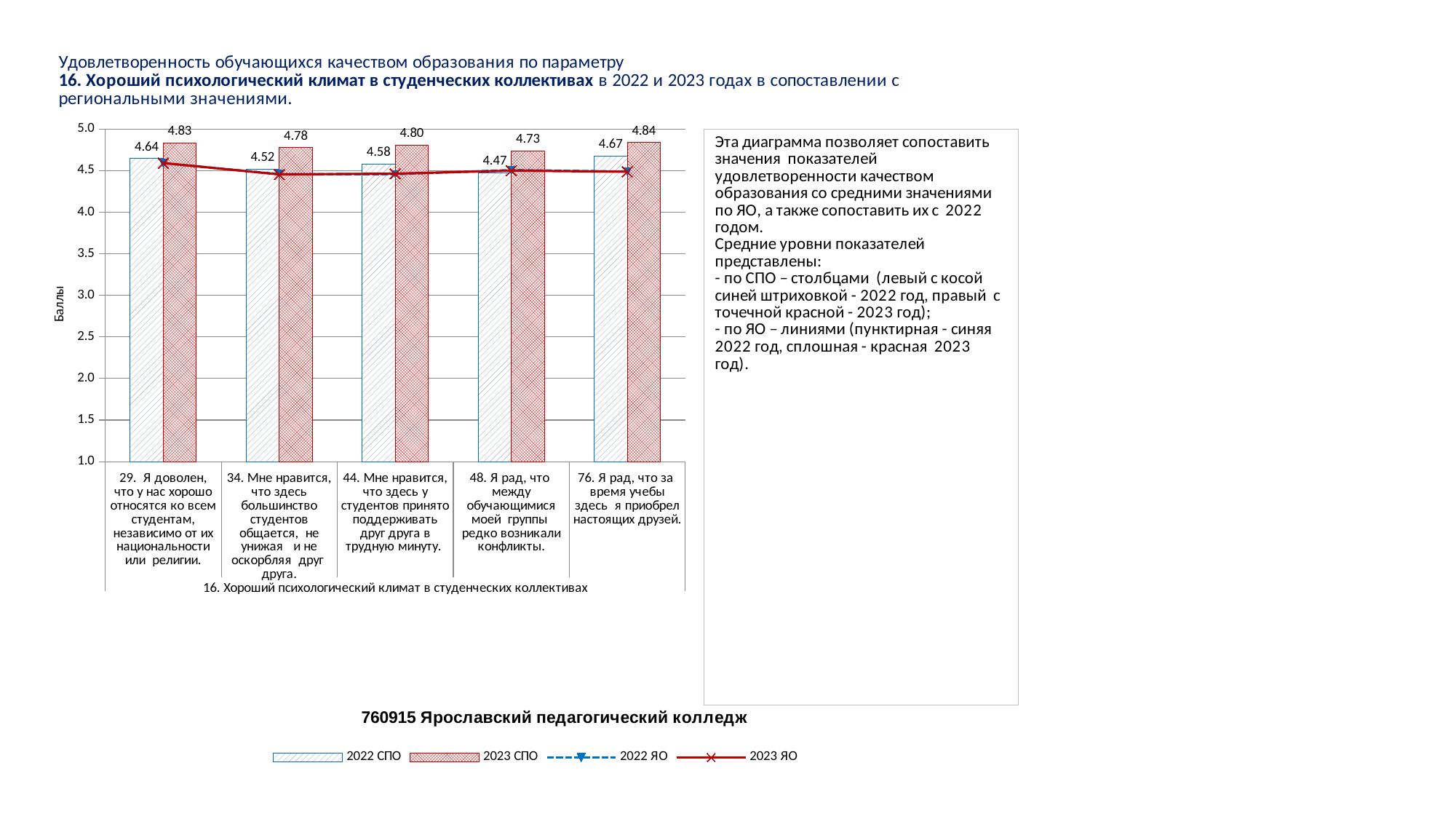
What is the 2023 СПО value for item 29 (Я доволен, что у нас хорошо относятся ко всем студентам)? 4.83 What is the label of the vertical axis? Баллы What kind of chart is used for the СПО values? bar chart Which item has the lowest 2022 СПО value? 48. Я рад, что между обучающимися моей группы редко возникали конфликты. Which item has the highest 2023 СПО value? 76. Я рад, что за время учебы здесь я приобрел настоящих друзей. Is the 2023 ЯО line value for item 34 greater or less than 4.5? less How many series does the legend list? 4 How many survey items (categories) are shown on the x axis? 5 What is the 2022 СПО value for item 44 (Мне нравится, что здесь у студентов принято поддерживать друг друга)? 4.58 What is the 2022 СПО value for item 48 (Я рад, что между обучающимися моей группы редко возникали конфликты)? 4.47 What is the difference between the 2023 СПО and 2022 СПО values for item 34? 0.26 For item 76, which is larger: the 2022 СПО value or the 2023 СПО value? 2023 СПО